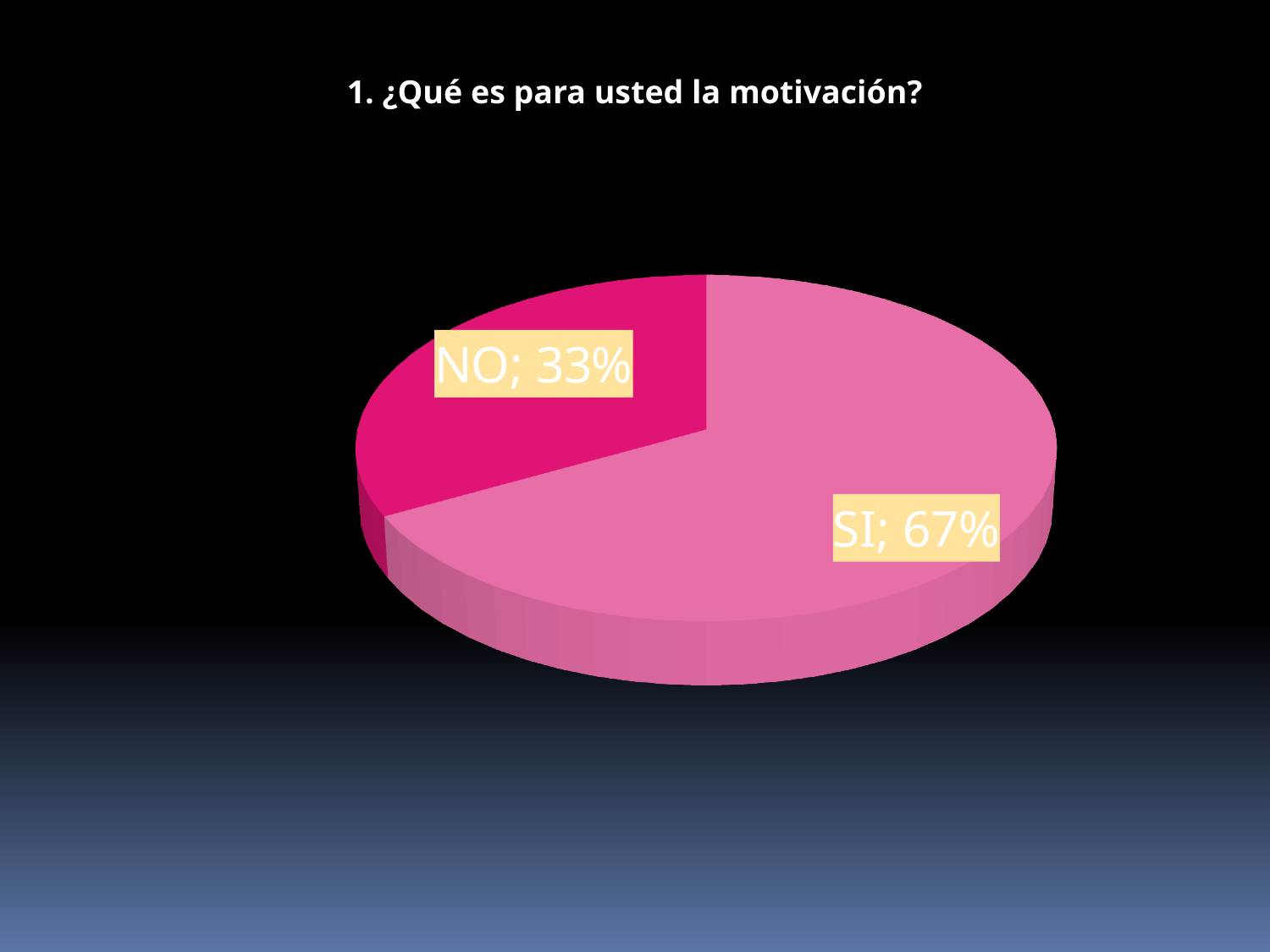
What percentage of the pie is labelled NO? 33% What kind of chart is shown on the slide? Pie chart Is the SI slice greater or less than 50% of the pie? greater What percentage of the pie is labelled SI? 67% How many slices does the pie chart have? 2 Which slice is the smallest in the pie chart? NO Which slice is larger, SI or NO? SI What is the title of the chart? 1. ¿Qué es para usted la motivación? What share of the pie does the NO slice represent? 33% What is the difference in percentage points between the SI and NO slices? 34 Which slice is the largest in the pie chart? SI